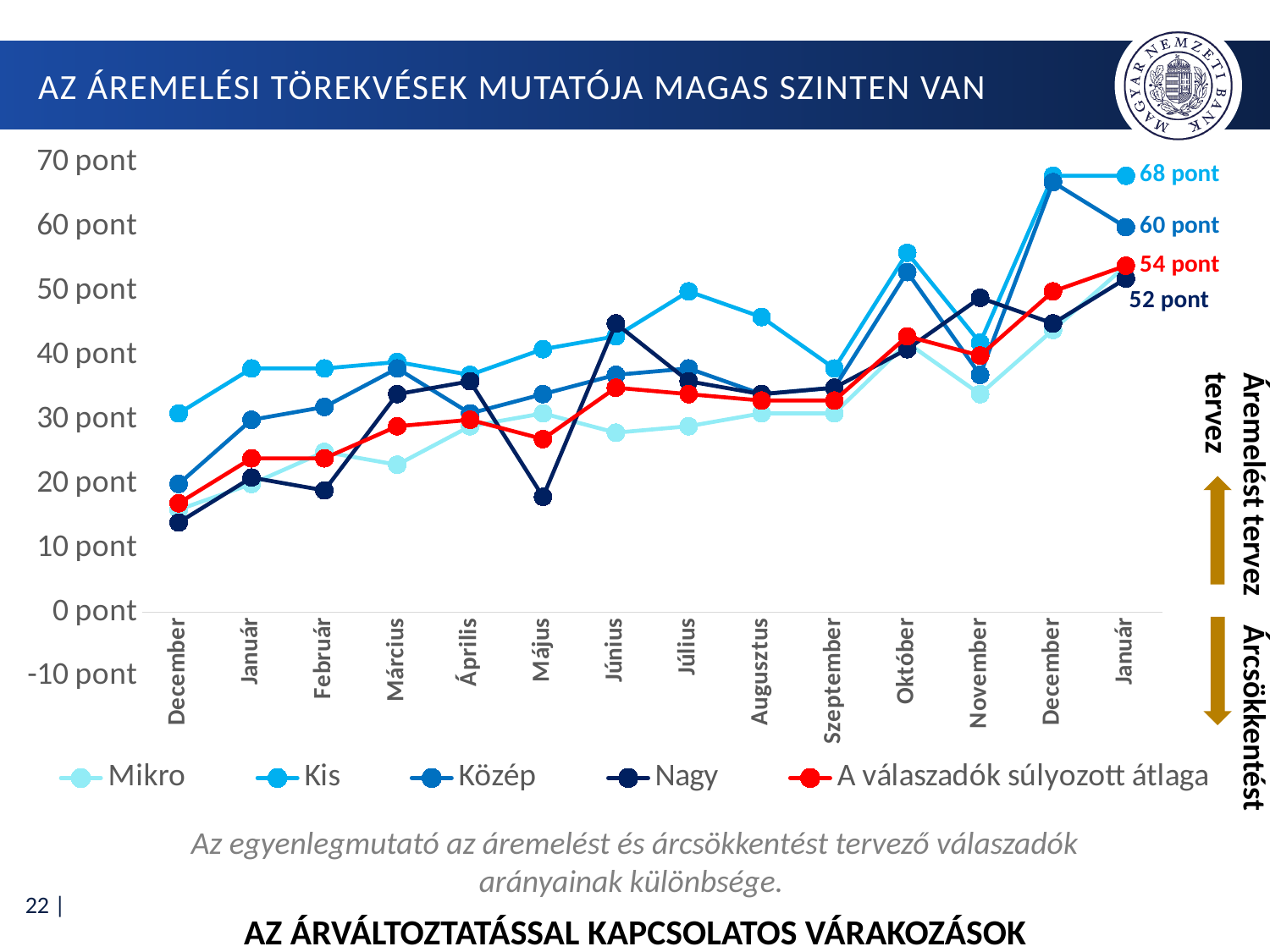
What is the value of the Közép series at the final Január point? 60 pont How many months are shown along the x axis? 14 What kind of chart is shown on the slide? line chart At the final Január point, what is the difference between the Kis value and the weighted average ('A válaszadók súlyozott átlaga')? 14 pont Is the value of the Kis series in Július greater or less than 40 pont? greater How many series does the legend list? 5 Does the weighted average series ('A válaszadók súlyozott átlaga') generally rise or fall from the first December to the final Január? rise What is the value of 'A válaszadók súlyozott átlaga' at the final Január point? 54 pont At the final Január point, what is the difference between the Kis value and the Közép value? 8 pont What is the value of the Nagy series at the final Január point? 52 pont What is the value of the Kis series at the final Január point? 68 pont At the final Január point, which is larger: the Kis value or the Nagy value? Kis